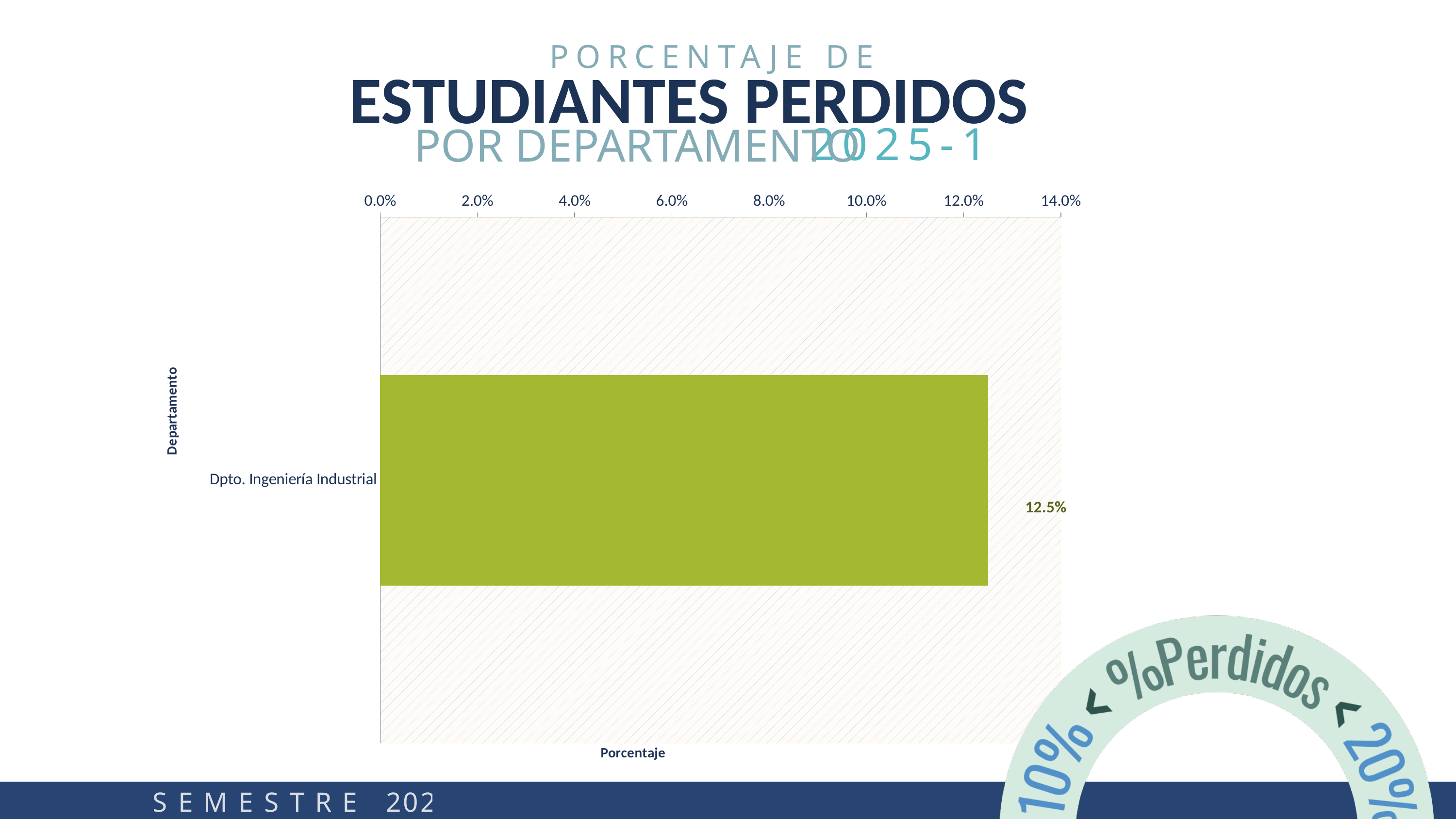
What is the maximum value shown on the horizontal axis? 14.0% What is the percentage of lost students for Dpto. Ingeniería Industrial? 12.5% What is the label of the horizontal axis? Porcentaje Is the value for Dpto. Ingeniería Industrial greater or less than 14.0%? less Which department is shown in the chart? Dpto. Ingeniería Industrial What is the label of the vertical axis? Departamento What kind of chart is shown on the slide? bar chart Is the value for Dpto. Ingeniería Industrial greater or less than 10.0%? greater How many departments are plotted in the chart? 1